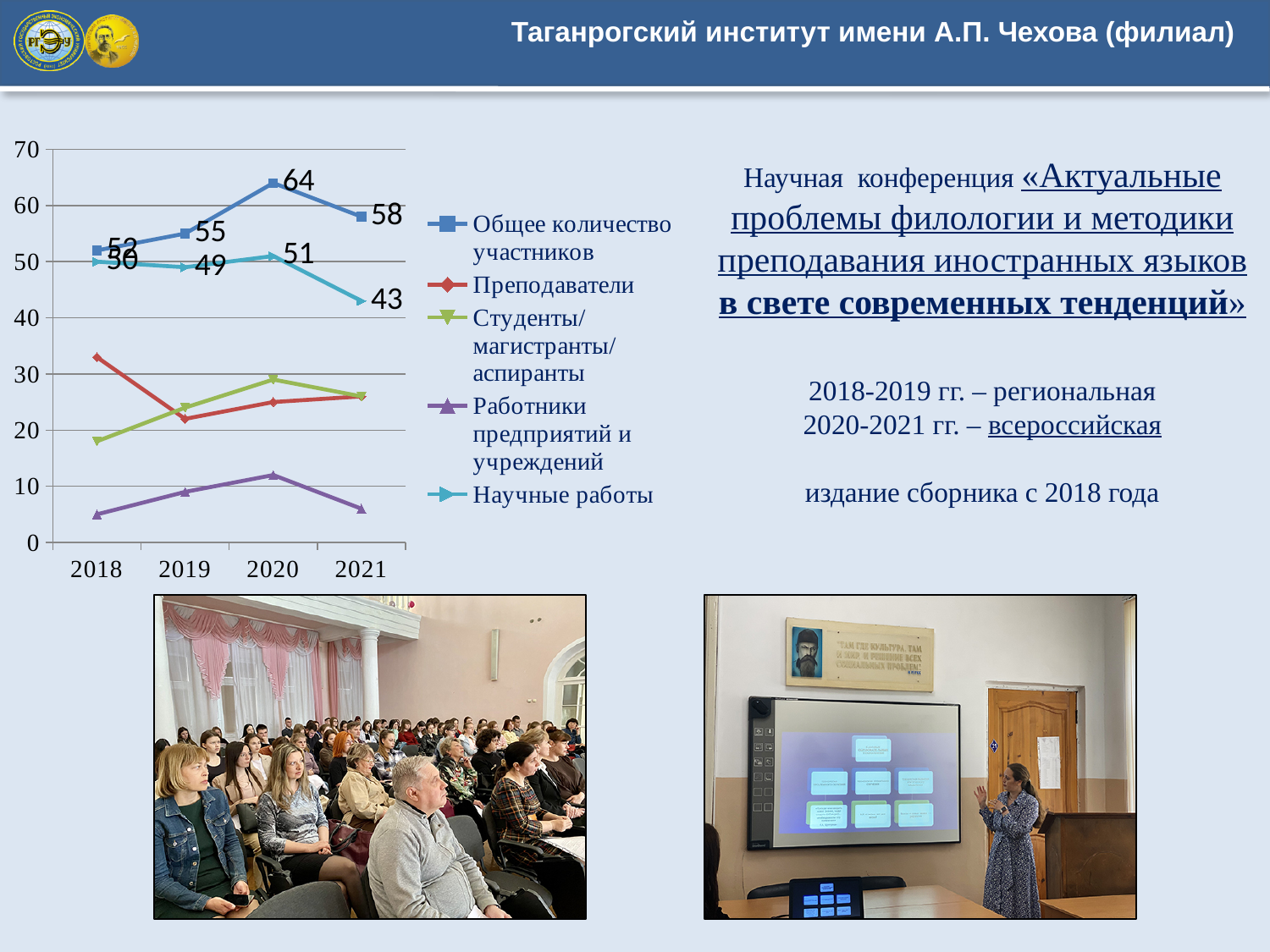
How many years are shown on the x axis of the chart? 4 Is the value for Преподаватели in 2018 greater or less than 30? greater In 2019, which is larger: Общее количество участников or Научные работы? Общее количество участников What is the value of Научные работы in 2019? 49 What kind of chart is shown on the slide? line chart How many series does the chart legend list? 5 In which year is Научные работы lowest? 2021 What is the difference between Общее количество участников in 2020 and in 2021? 6 What is the value of Общее количество участников in 2020? 64 In which year is Общее количество участников highest? 2020 Does Общее количество участников rise or fall from 2018 to 2020? rise What is the value of Научные работы in 2021? 43